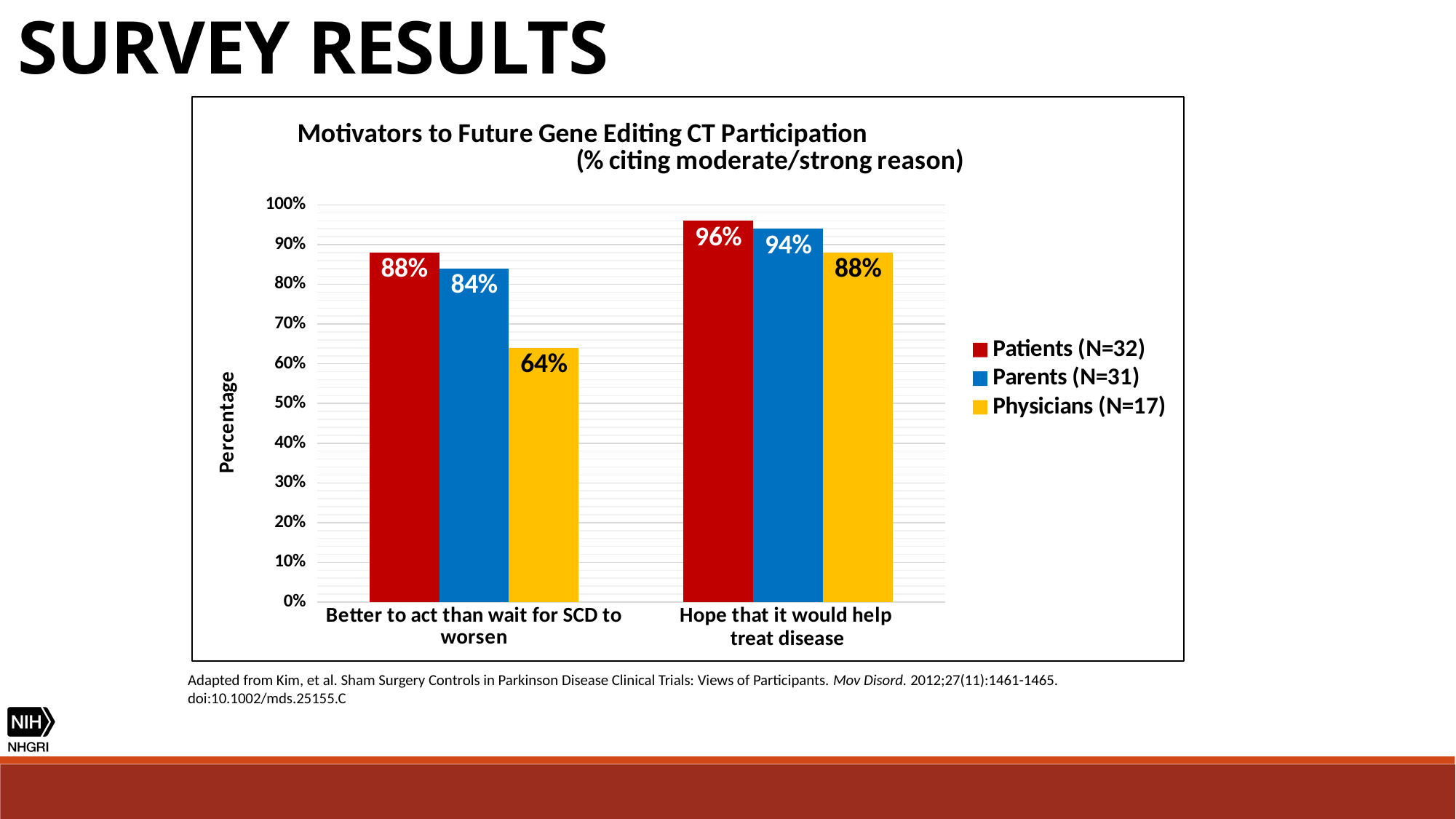
What percentage of Physicians cited 'Hope that it would help treat disease' as a moderate/strong reason? 88% Which group has the lowest value for 'Better to act than wait for SCD to worsen'? Physicians (N=17) Which is larger: the Parents value for 'Hope that it would help treat disease' or the Parents value for 'Better to act than wait for SCD to worsen'? Hope that it would help treat disease What colour represents Physicians (N=17) in the chart? Yellow What is the value for Parents for 'Better to act than wait for SCD to worsen'? 84% Which group has the highest value for 'Hope that it would help treat disease'? Patients (N=32) What percentage of Patients cited 'Better to act than wait for SCD to worsen' as a moderate/strong reason? 88% How many series does the legend list? 3 How many motivator categories are shown on the x axis? 2 What is the difference between the Patients and Physicians values for 'Better to act than wait for SCD to worsen'? 24% What kind of chart is shown on the slide? Bar chart What is the difference between the Patients and Parents values for 'Hope that it would help treat disease'? 2%